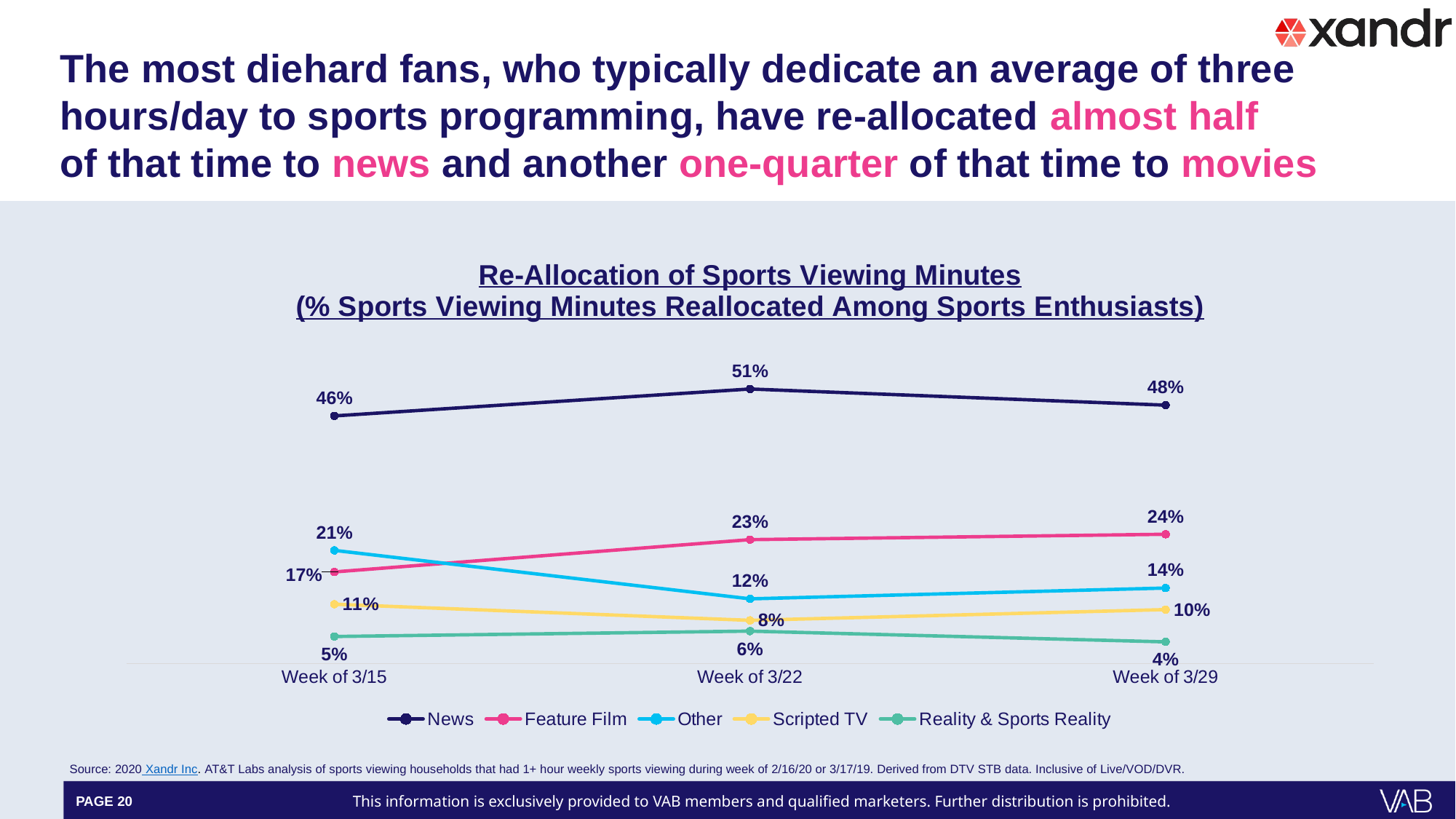
Does the Feature Film series rise or fall from the Week of 3/15 to the Week of 3/29? Rise In which week is the News value highest? Week of 3/22 In the Week of 3/15, which is larger: the value for Other or the value for Feature Film? Other Which series has the lowest value in the Week of 3/29? Reality & Sports Reality How many weeks are plotted along the x axis? 3 What is the value for Other in the Week of 3/15? 21% What is the difference between the News value and the Feature Film value in the Week of 3/29? 24% How many series does the legend list? 5 What is the value for Feature Film in the Week of 3/29? 24% What is the value for News in the Week of 3/22? 51% What kind of chart is shown on the slide? Line chart What is the value for Scripted TV in the Week of 3/22? 8%